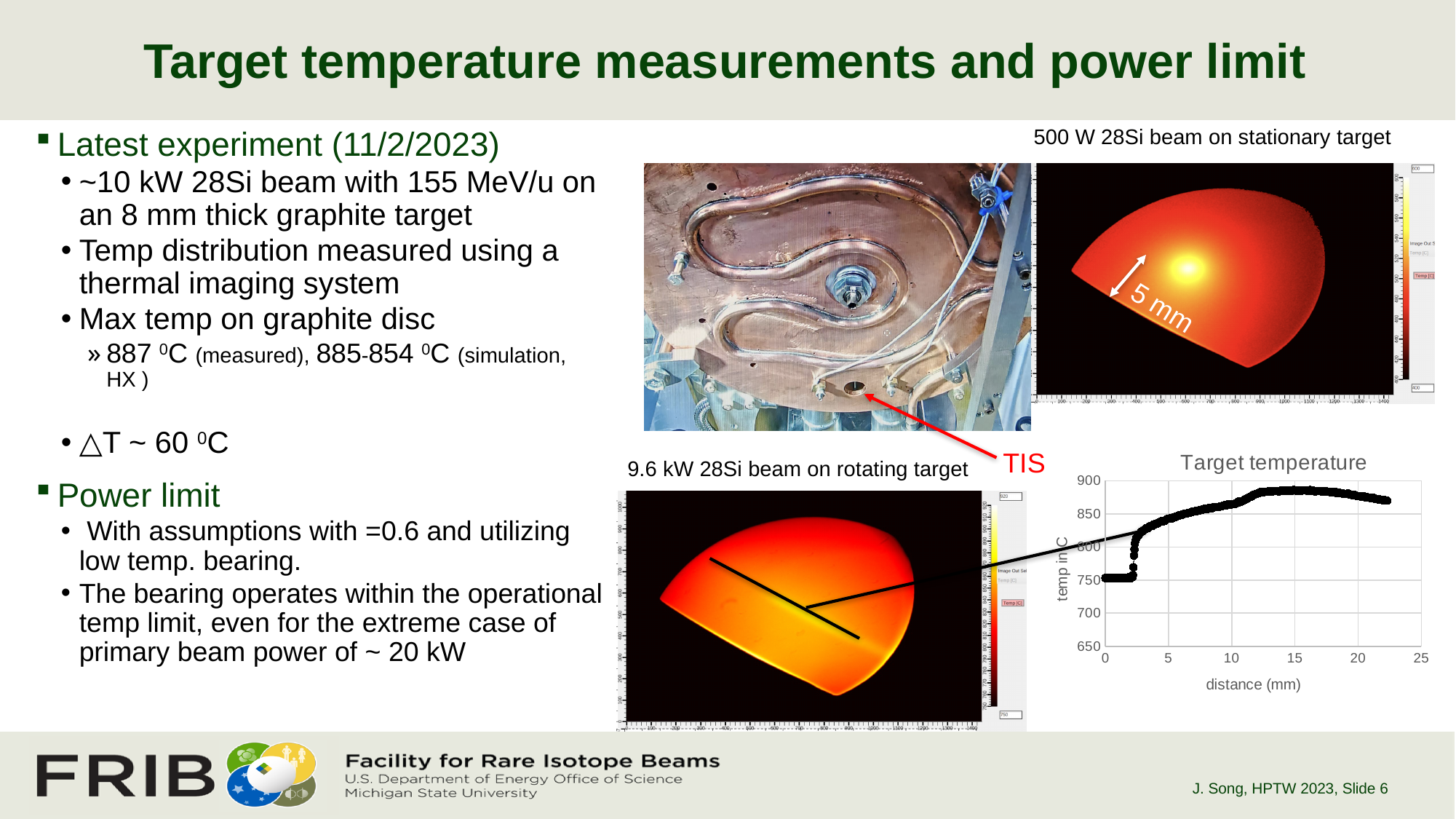
What is the title of the chart on the slide? Target temperature What kind of chart is the "Target temperature" chart? scatter plot In the "Target temperature" chart, is the temperature at a distance of 0 mm greater or less than 800? less In the "Target temperature" chart, do the temperature values rise or fall as distance increases from 0 mm to 15 mm? rise In the "Target temperature" chart, is the temperature at a distance of 15 mm greater or less than 850? greater What is the label of the x axis of the "Target temperature" chart? distance (mm) In the "Target temperature" chart, is the temperature at a distance of 10 mm greater or less than 800? greater In the "Target temperature" chart, which has the lower temperature: the point at 0 mm or the point at 10 mm? 0 mm In the "Target temperature" chart, which has the higher temperature: the point at 5 mm or the point at 15 mm? 15 mm What is the highest tick value shown on the y axis of the "Target temperature" chart? 900